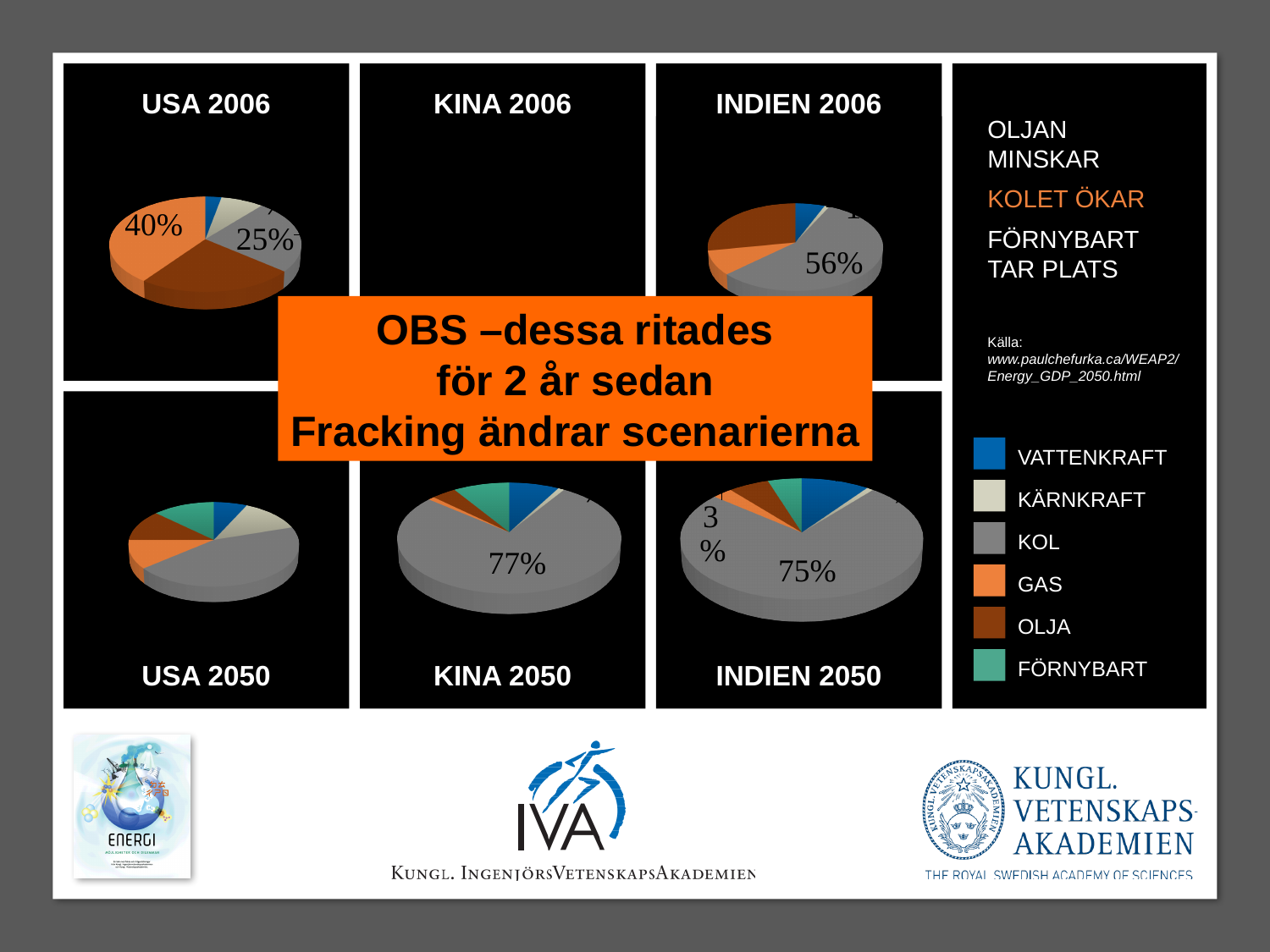
In the INDIEN 2006 pie chart, what share is labelled on the KOL (grey) slice? 56% Which colour does the legend use for GAS? Orange In the KINA 2050 pie chart, what share is labelled on the KOL (grey) slice? 77% What kind of charts are shown on the slide for USA, KINA and INDIEN? Pie charts Which legend entry is shown in green? FÖRNYBART In the USA 2006 pie chart, which energy source has the largest slice? GAS By how many percentage points does the KOL share in KINA 2050 exceed the KOL share in INDIEN 2050? 2 percentage points In the USA 2050 pie chart, which energy source has the largest slice? KOL In the KINA 2050 pie chart, which energy source has the largest slice? KOL How many entries does the legend on the right of the slide list? 6 Which pie chart shows a larger share for KOL, KINA 2050 or INDIEN 2050? KINA 2050 In the INDIEN 2050 pie chart, what share is labelled on the KOL (grey) slice? 75%